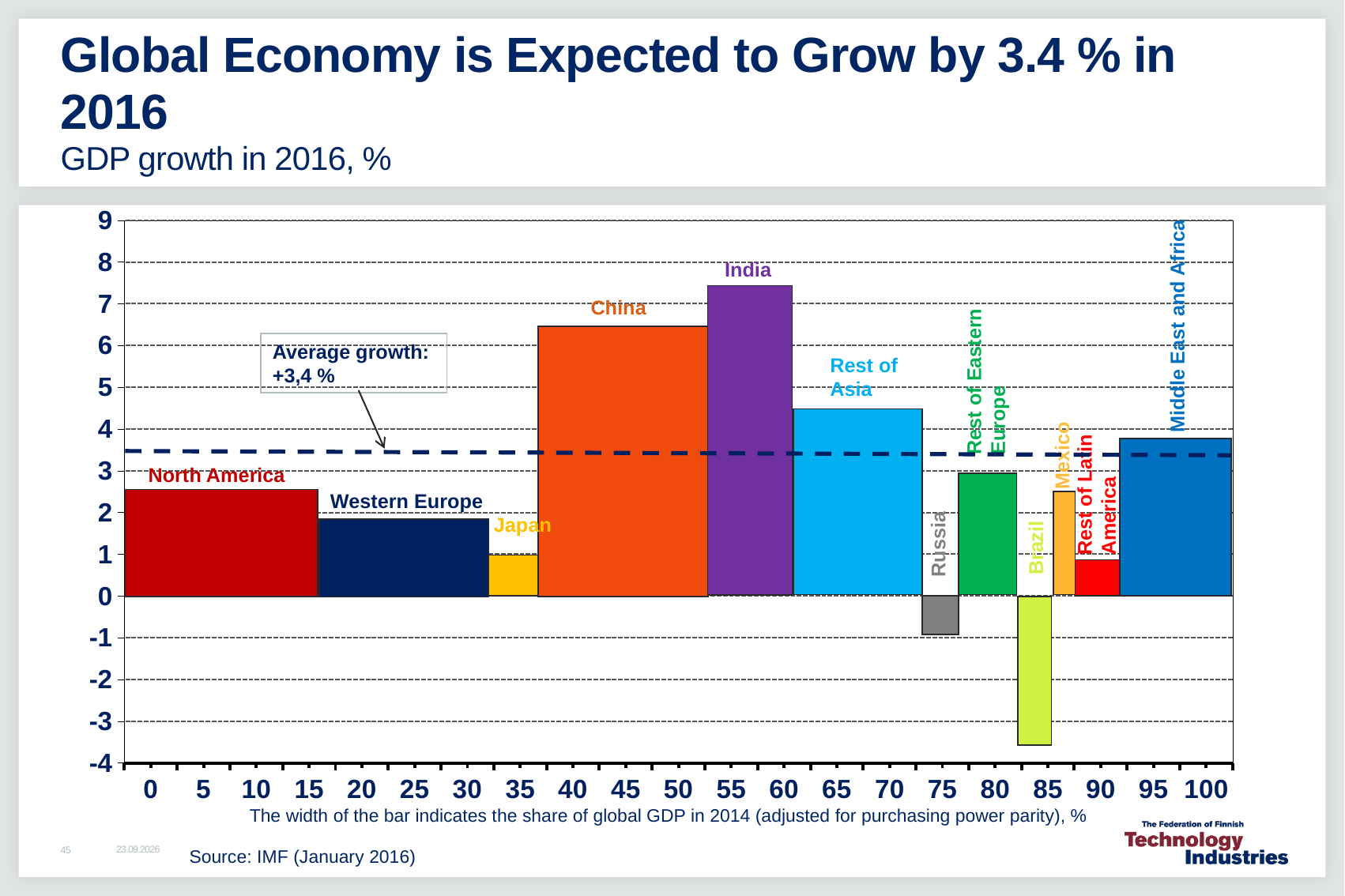
Is the GDP growth value for Rest of Asia greater or less than 4? greater What average growth value is indicated by the dashed line annotation on the chart? +3,4 % Is the GDP growth value for China greater or less than 6? greater How many regions (bars) are shown on the chart? 12 Which region has the highest GDP growth in 2016 on the chart? India Which has higher GDP growth in 2016, North America or Western Europe? North America How many regions on the chart have negative GDP growth in 2016? 2 What kind of chart is shown on the slide? bar chart Is the GDP growth value for Russia greater or less than 0? less Which region has the lowest GDP growth in 2016 on the chart? Brazil Which has higher GDP growth in 2016, China or India? India